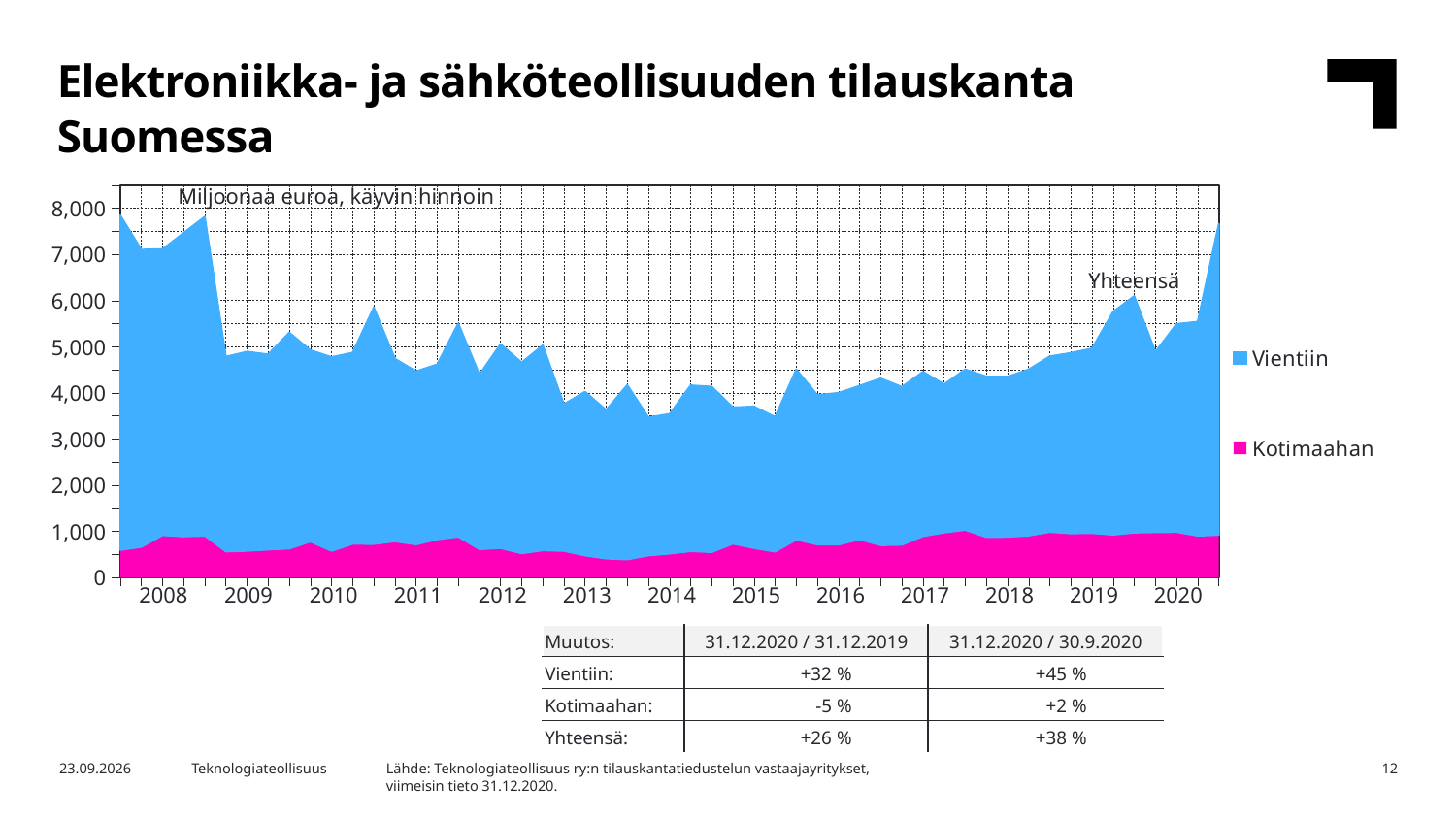
What unit is stated in the label at the top of the chart? Miljoonaa euroa, käyvin hinnoin According to the table below the chart, what is the change in Vientiin for 31.12.2020 / 31.12.2019? +32 % Does the total order book (Yhteensä) rise or fall from 2008 to 2009? fall How many year labels are shown on the x axis of the chart? 13 Is the total (Yhteensä) value at the start of 2008 greater or less than 7,000? greater What kind of chart is shown on the slide? Area chart Is the Kotimaahan value in 2013 greater or less than 1,000? less What are the two series named in the chart legend? Vientiin and Kotimaahan Does the total order book (Yhteensä) rise or fall from 2015 to 2020? rise How many series does the chart legend list? 2 Which series has the larger value in 2020, Vientiin or Kotimaahan? Vientiin Is the total (Yhteensä) value in 2015 greater or less than 5,000? less